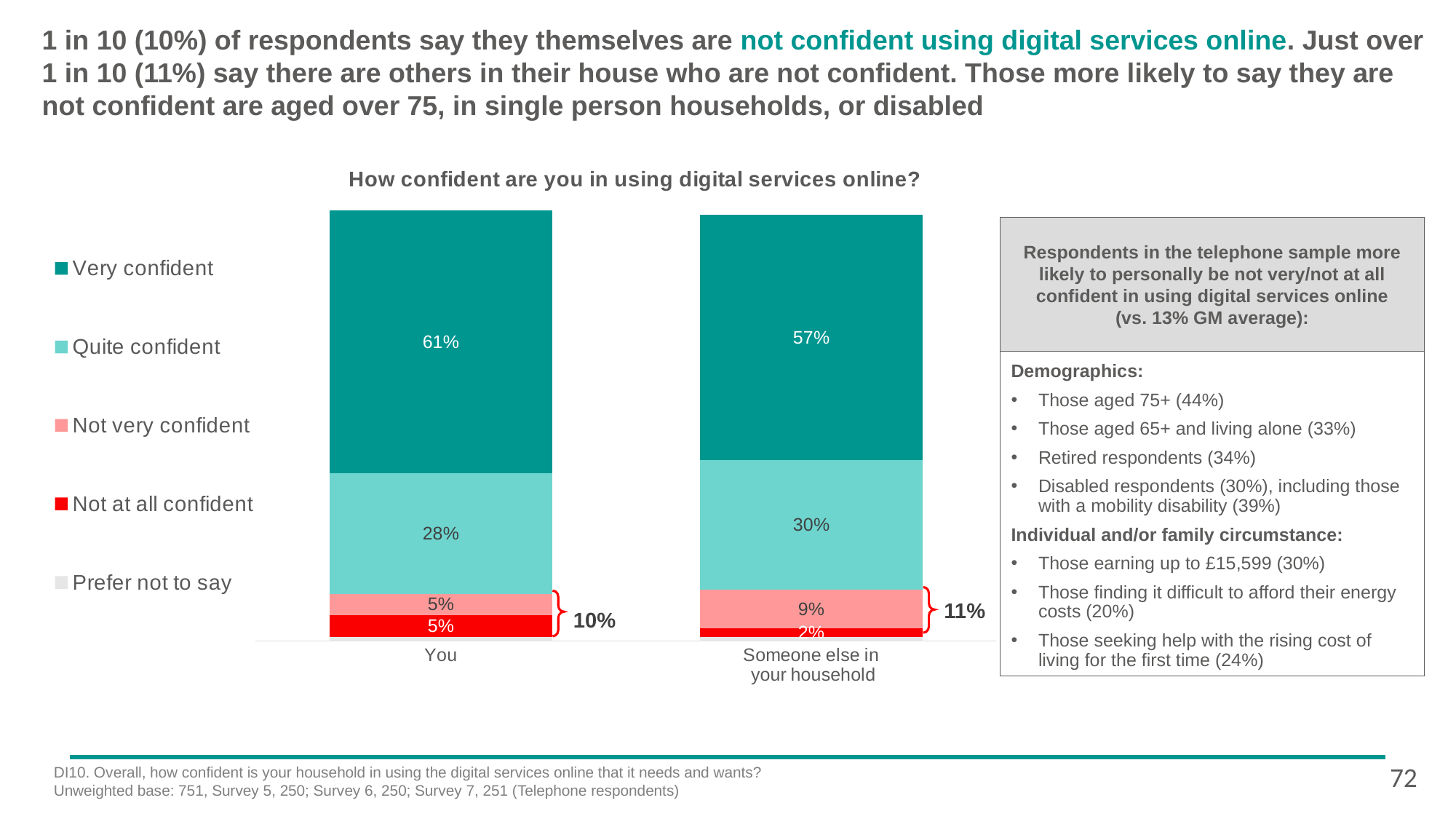
What is the title of the chart? How confident are you in using digital services online? What is the 'Quite confident' value for 'Someone else in your household'? 30% What is the difference between the 'Very confident' values for 'You' and 'Someone else in your household'? 4 percentage points What is the combined 'Not very confident' and 'Not at all confident' share shown by the bracket for 'You'? 10% How many series does the legend list? 5 What kind of chart is shown on the slide? Stacked bar chart What is the 'Not very confident' value for the 'You' bar? 5% Which bar has the higher 'Very confident' value, 'You' or 'Someone else in your household'? You What is the combined 'Not very confident' and 'Not at all confident' share shown by the bracket for 'Someone else in your household'? 11% What percentage of respondents say they themselves are very confident using digital services online? 61% How many bars are plotted in the chart? 2 What is the 'Not at all confident' value for 'Someone else in your household'? 2%